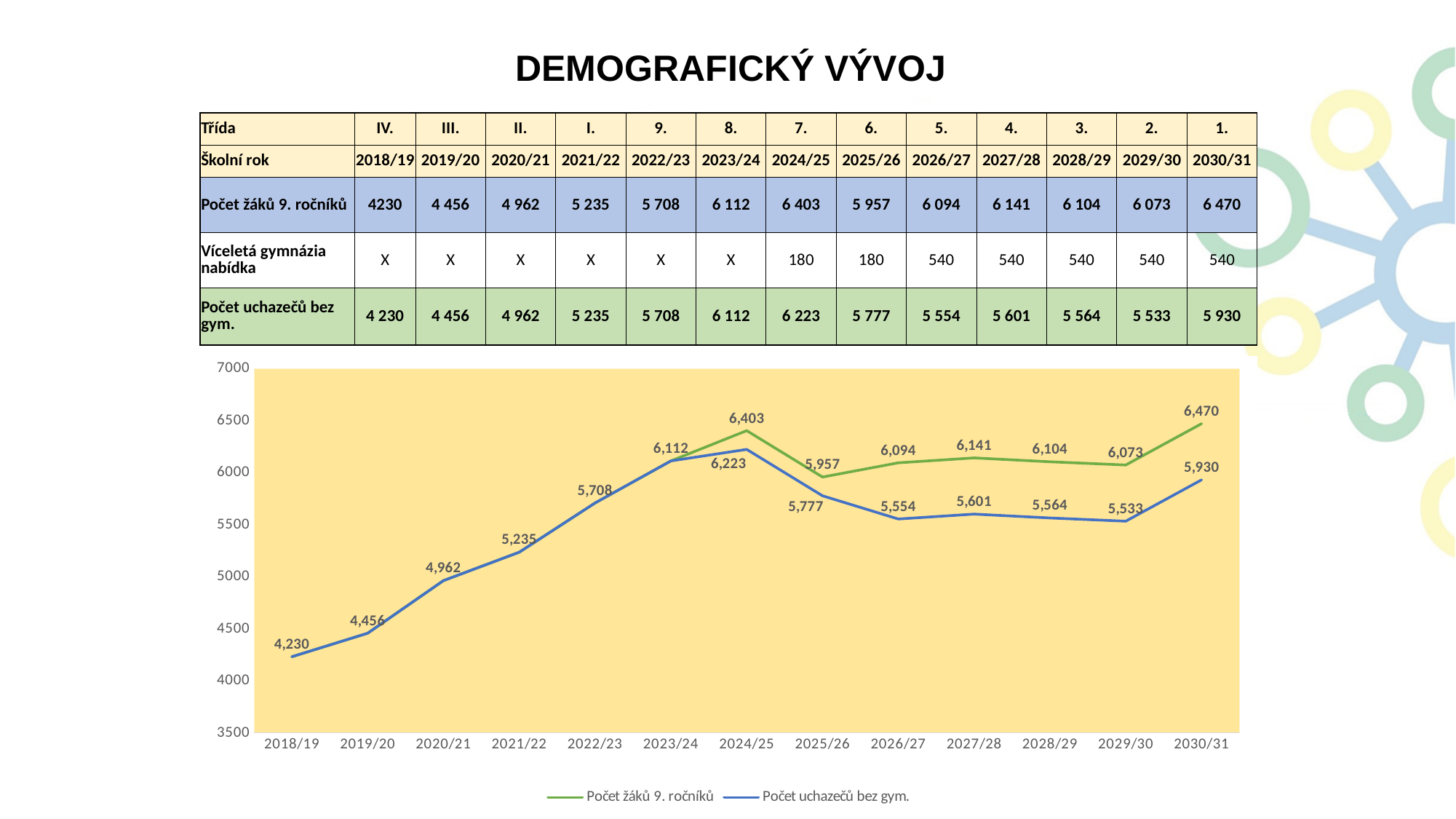
How many school years are plotted along the x axis of the chart? 13 What is the value of Počet uchazečů bez gym. for 2029/30 in the chart? 5,533 In which school year does Počet žáků 9. ročníků reach its highest value in the chart? 2030/31 What is the difference between Počet žáků 9. ročníků and Počet uchazečů bez gym. in 2030/31? 540 Which is larger in 2026/27: Počet žáků 9. ročníků or Počet uchazečů bez gym.? Počet žáků 9. ročníků What is the value of Počet žáků 9. ročníků for 2024/25 in the chart? 6,403 Which colour is the line for Počet uchazečů bez gym. in the chart? blue In which school year is Počet uchazečů bez gym. lowest in the chart? 2018/19 What kind of chart is shown on the slide? line chart How many series does the chart legend list? 2 Does Počet uchazečů bez gym. rise or fall from 2018/19 to 2023/24? rise What is the value of Počet uchazečů bez gym. for 2018/19 in the chart? 4,230